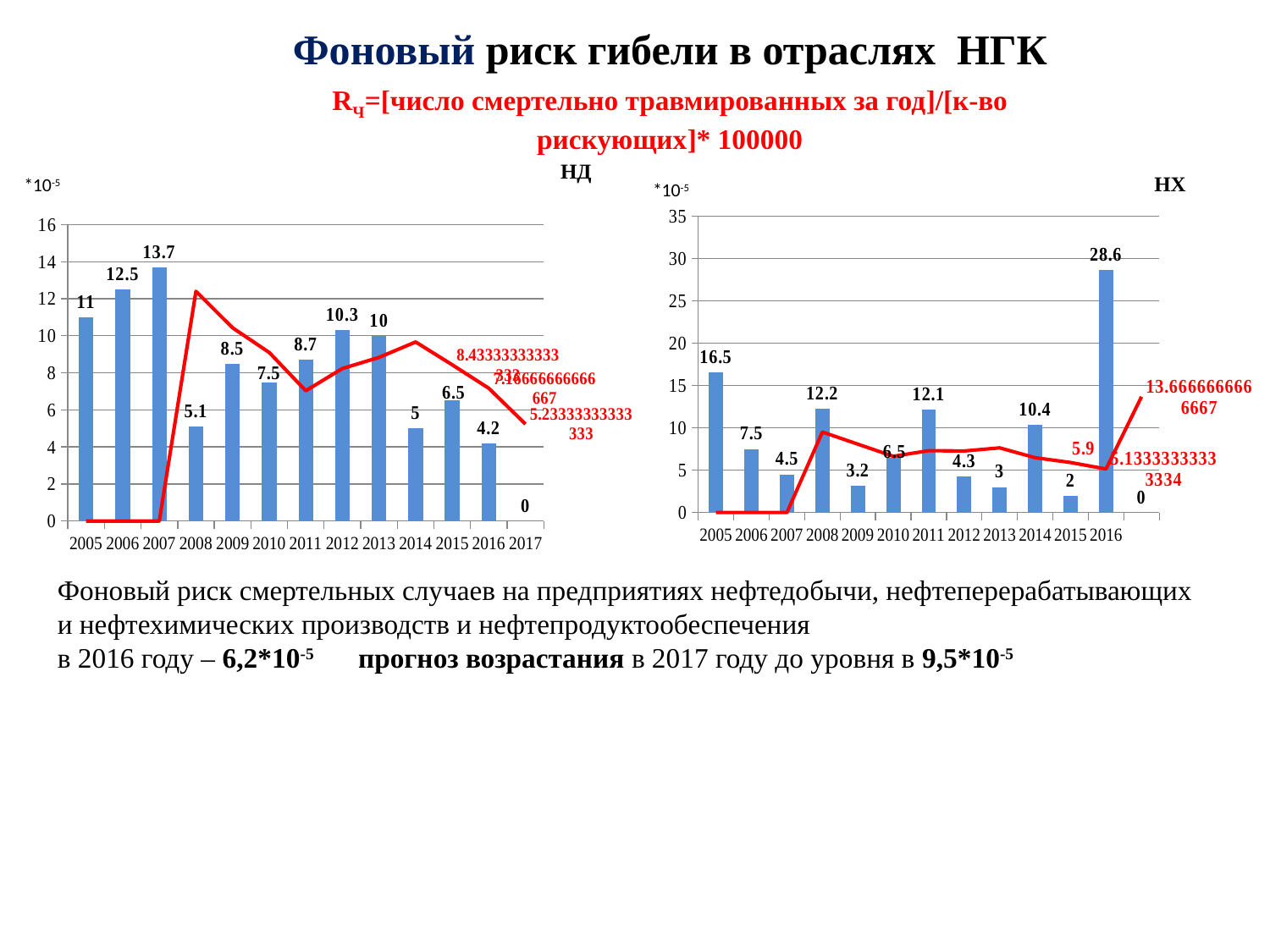
In the НХ chart (right), which year has the highest bar? 2016 In the НД chart (left), which year has the highest bar? 2007 How many years are shown on the x axis of the НД chart (left)? 13 In the НХ chart (right), which year has the lowest bar? 2015 In the НХ chart (right), what is the difference between the bar values for 2016 and 2005? 12.1 In the НД chart (left), what is the bar value for 2007? 13.7 In the НХ chart (right), what is the bar value for 2016? 28.6 In the НД chart (left), what is the difference between the bar values for 2006 and 2005? 1.5 In the НД chart (left), do the bar values rise or fall from 2005 to 2007? rise In the НД chart (left), is the bar value for 2007 greater or less than 12? greater What kind of chart is the НХ chart (right)? bar chart with a line overlay In the НХ chart (right), which year has the larger bar value, 2014 or 2006? 2014